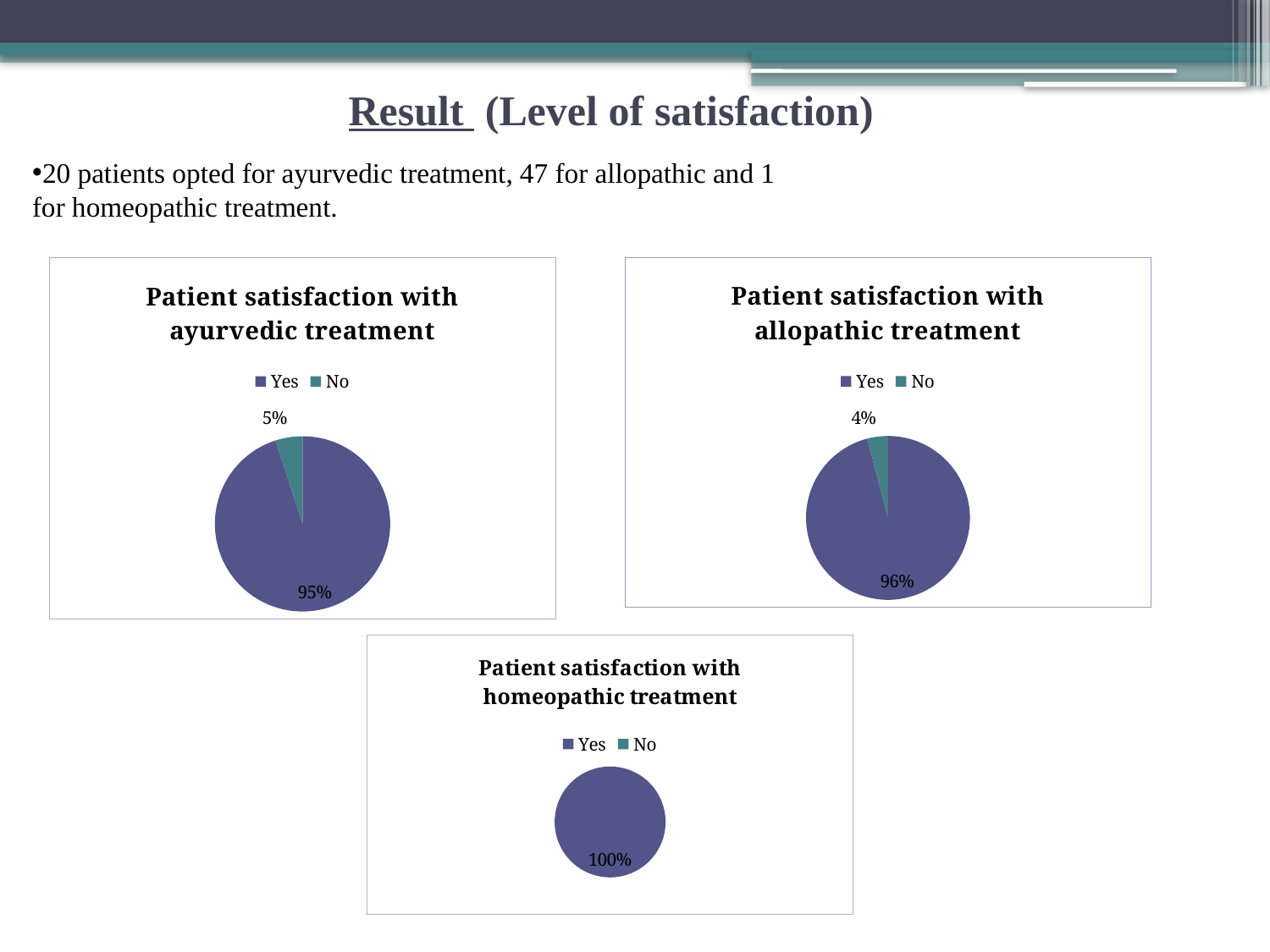
In the 'Patient satisfaction with ayurvedic treatment' chart, what share of the pie is 'Yes'? 95% In the 'Patient satisfaction with allopathic treatment' chart, which is larger, the 'Yes' slice or the 'No' slice? Yes In the 'Patient satisfaction with allopathic treatment' chart, what share of the pie is 'Yes'? 96% What kind of chart is 'Patient satisfaction with ayurvedic treatment'? Pie chart How many entries does the legend of the 'Patient satisfaction with homeopathic treatment' chart list? 2 In the 'Patient satisfaction with allopathic treatment' chart, what share of the pie is 'No'? 4% How many pie charts are shown on the slide? 3 In the 'Patient satisfaction with ayurvedic treatment' chart, what is the difference between the 'Yes' and 'No' shares? 90% In the 'Patient satisfaction with allopathic treatment' chart, which category has the largest slice? Yes In the 'Patient satisfaction with ayurvedic treatment' chart, which category has the smallest slice? No